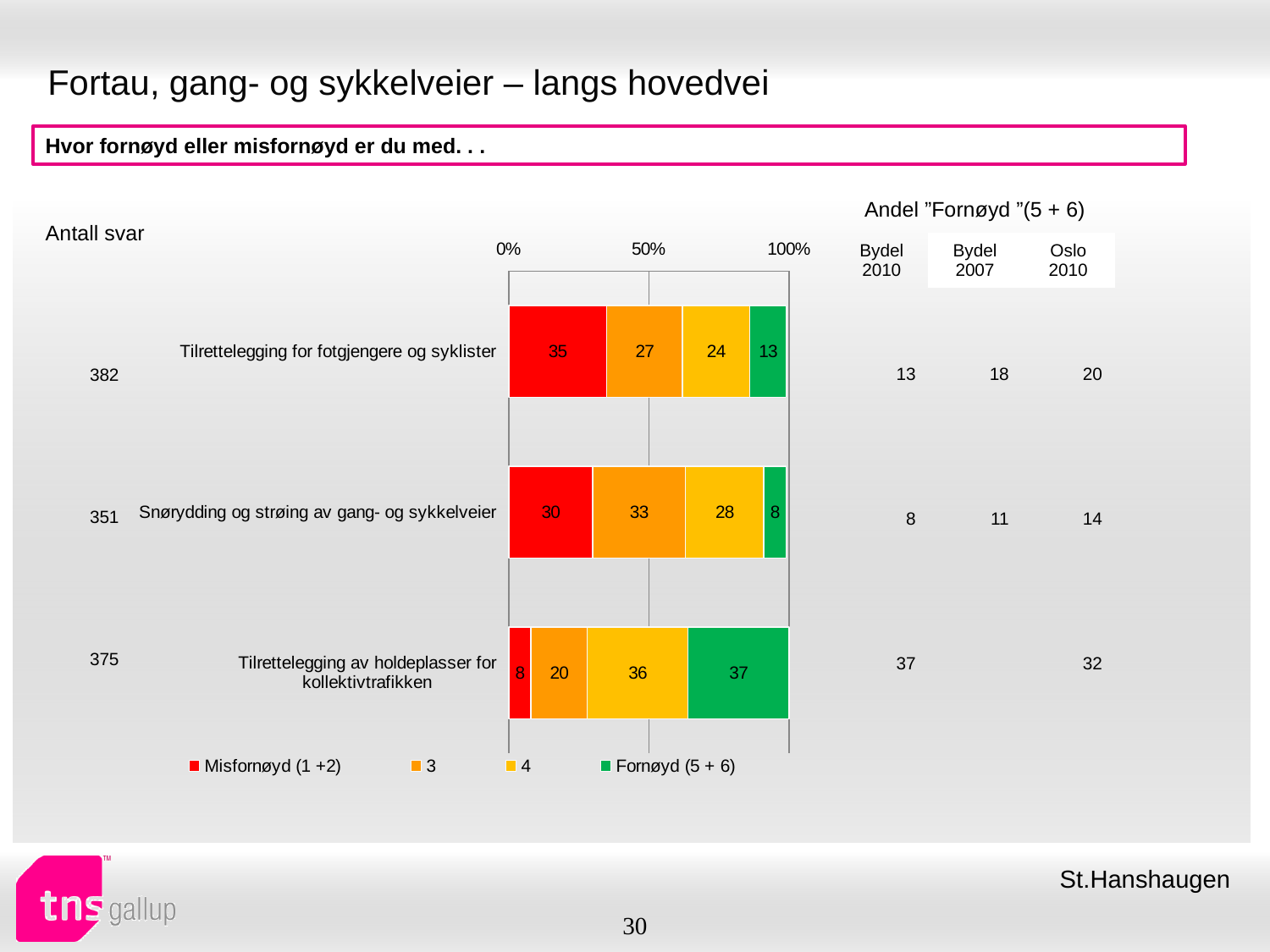
How many series does the legend list? 4 What kind of chart is shown on the slide? Stacked bar chart Which category has the lowest "Misfornøyd (1 +2)" value? Tilrettelegging av holdeplasser for kollektivtrafikken What is the value of series "4" for "Tilrettelegging av holdeplasser for kollektivtrafikken"? 36 What is the value of "Fornøyd (5 + 6)" for "Snørydding og strøing av gang- og sykkelveier"? 8 Which is larger: the series "3" value for "Snørydding og strøing av gang- og sykkelveier" or for "Tilrettelegging for fotgjengere og syklister"? Snørydding og strøing av gang- og sykkelveier How many categories are shown in the chart? 3 What colour represents "Fornøyd (5 + 6)" in the chart? Green What is the total of the stacked bar for "Tilrettelegging av holdeplasser for kollektivtrafikken"? 101 What is the value of "Misfornøyd (1 +2)" for "Tilrettelegging for fotgjengere og syklister"? 35 Which category has the highest "Fornøyd (5 + 6)" value? Tilrettelegging av holdeplasser for kollektivtrafikken What is the difference between the "Misfornøyd (1 +2)" values for "Tilrettelegging for fotgjengere og syklister" and "Snørydding og strøing av gang- og sykkelveier"? 5